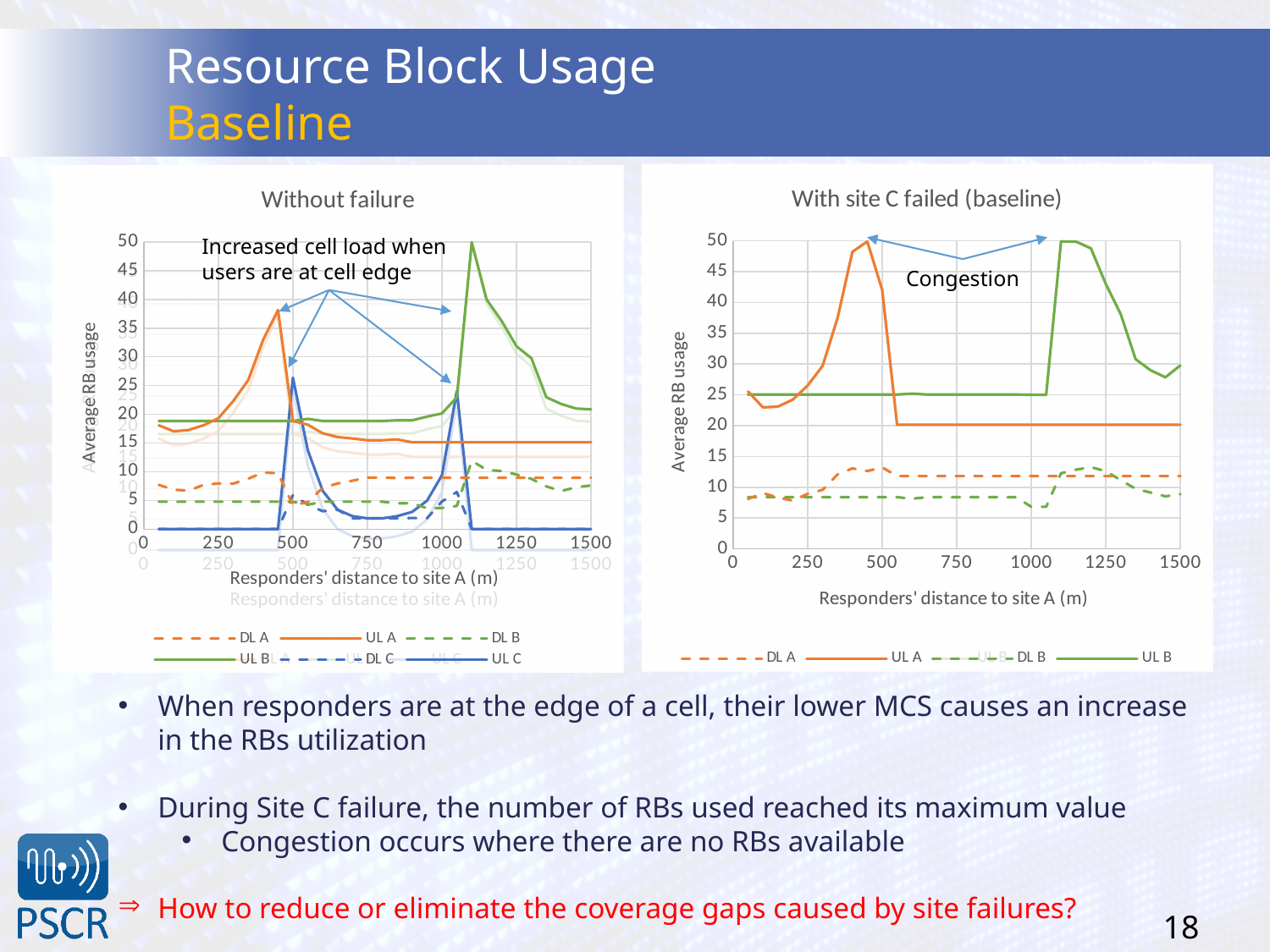
In the 'With site C failed (baseline)' chart, is the value of UL A at 1500 m greater or less than 25? less In the 'Without failure' chart, is the value of DL B at 250 m greater or less than 10? less How many series does the legend of the 'Without failure' chart list? 6 In the 'Without failure' chart, is the peak value of UL A greater or less than 40? less In the 'Without failure' chart, which series is higher at 1500 m, UL A or UL B? UL B What is the x-axis title of the 'With site C failed (baseline)' chart? Responders' distance to site A (m) How many series does the legend of the 'With site C failed (baseline)' chart list? 4 What kind of chart is the 'Without failure' chart? line chart In the 'With site C failed (baseline)' chart, which series is higher at 750 m, UL A or UL B? UL B